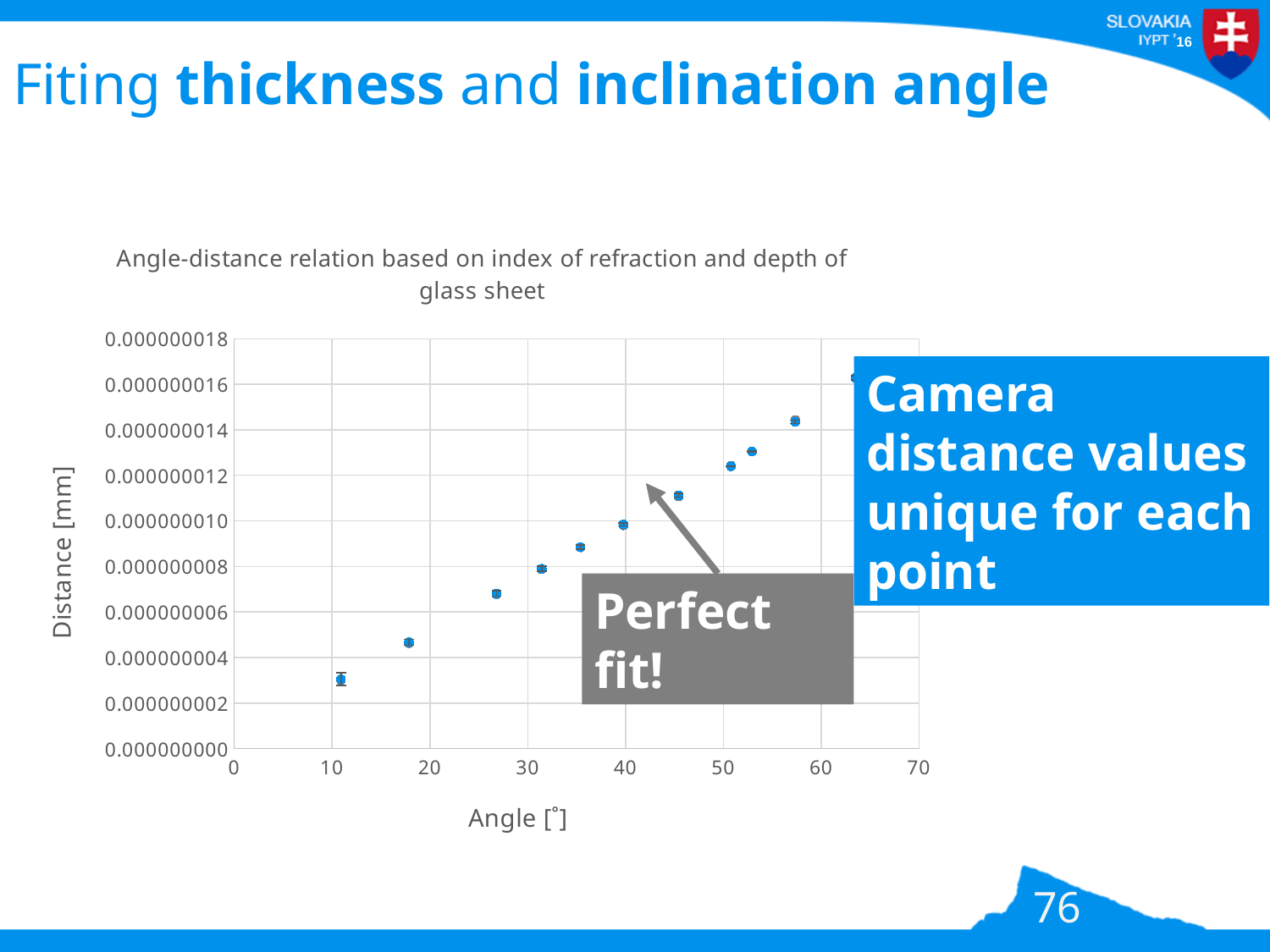
What is the title of the chart? Angle-distance relation based on index of refraction and depth of glass sheet As the angle increases along the x axis, does the distance rise or fall? Rise Is the distance for the point at an angle of about 11° greater or less than 0.000000004? less Which has the smaller distance: the point at about 45° or the point at about 18°? The point at about 18° Which has the larger distance: the point at about 31° or the point at about 51°? The point at about 51° What is the label of the y axis of the chart? Distance [mm] Is the distance for the point at an angle of about 40° greater or less than 0.000000008? greater Is the distance for the point at an angle of about 57° greater or less than 0.000000012? greater What kind of chart is shown on the slide? Scatter chart